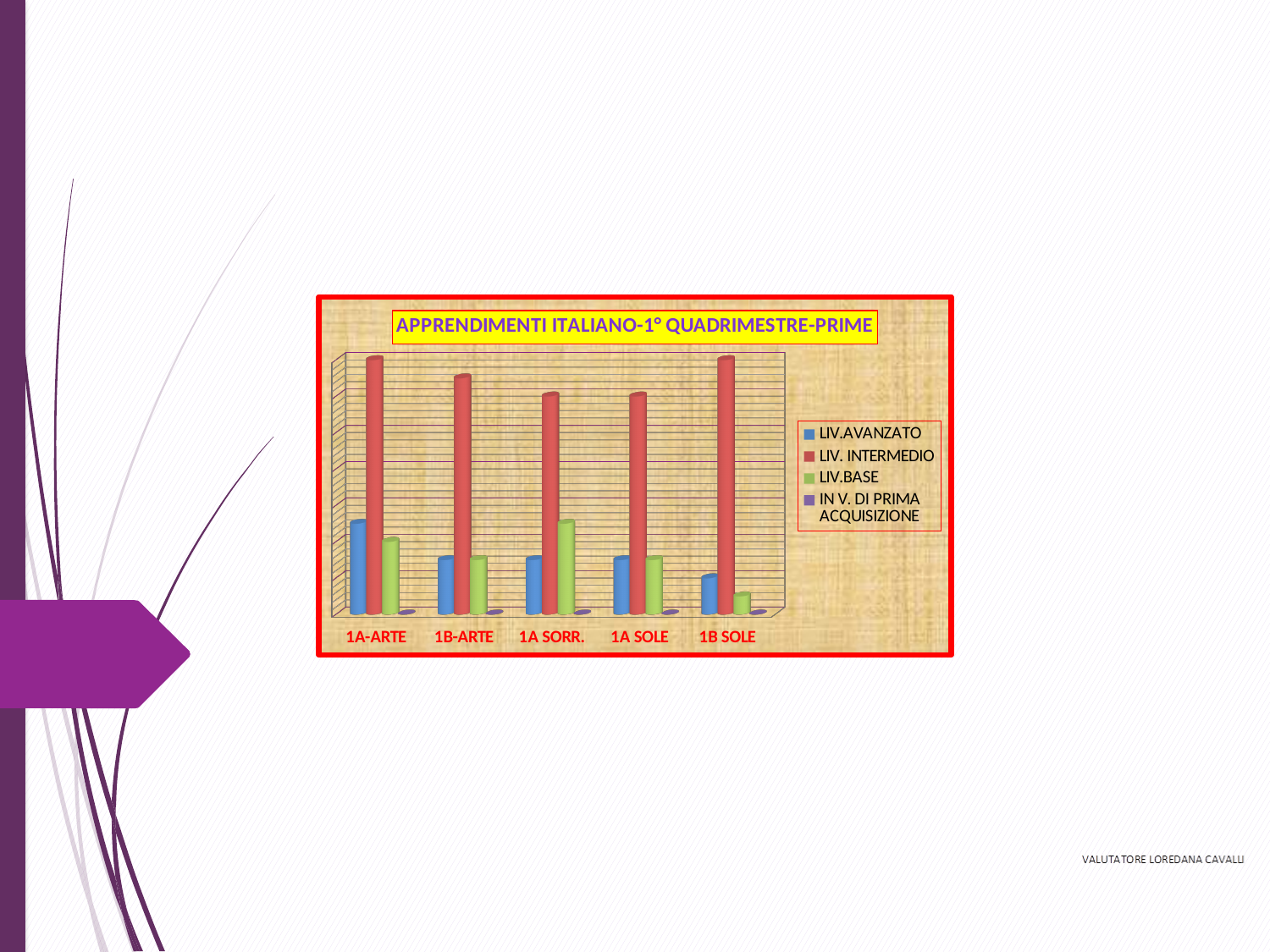
Which class has the lowest LIV.AVANZATO bar? 1B SOLE In class 1A SORR., which is larger: LIV.AVANZATO or LIV.BASE? LIV.BASE Which series is represented by the red bars in the chart? LIV. INTERMEDIO What is the title of the chart? APPRENDIMENTI ITALIANO-1° QUADRIMESTRE-PRIME Is the LIV. INTERMEDIO bar larger for 1A-ARTE or for 1B-ARTE? 1A-ARTE Which class has the highest LIV.BASE bar? 1A SORR. Which series has the tallest bar in every class shown in the chart? LIV. INTERMEDIO How many series does the chart's legend list? 4 Which class has the lowest LIV.BASE bar? 1B SOLE What kind of chart is shown on the slide? bar chart Which class has the highest LIV.AVANZATO bar? 1A-ARTE How many classes (categories) are shown on the x axis of the chart? 5